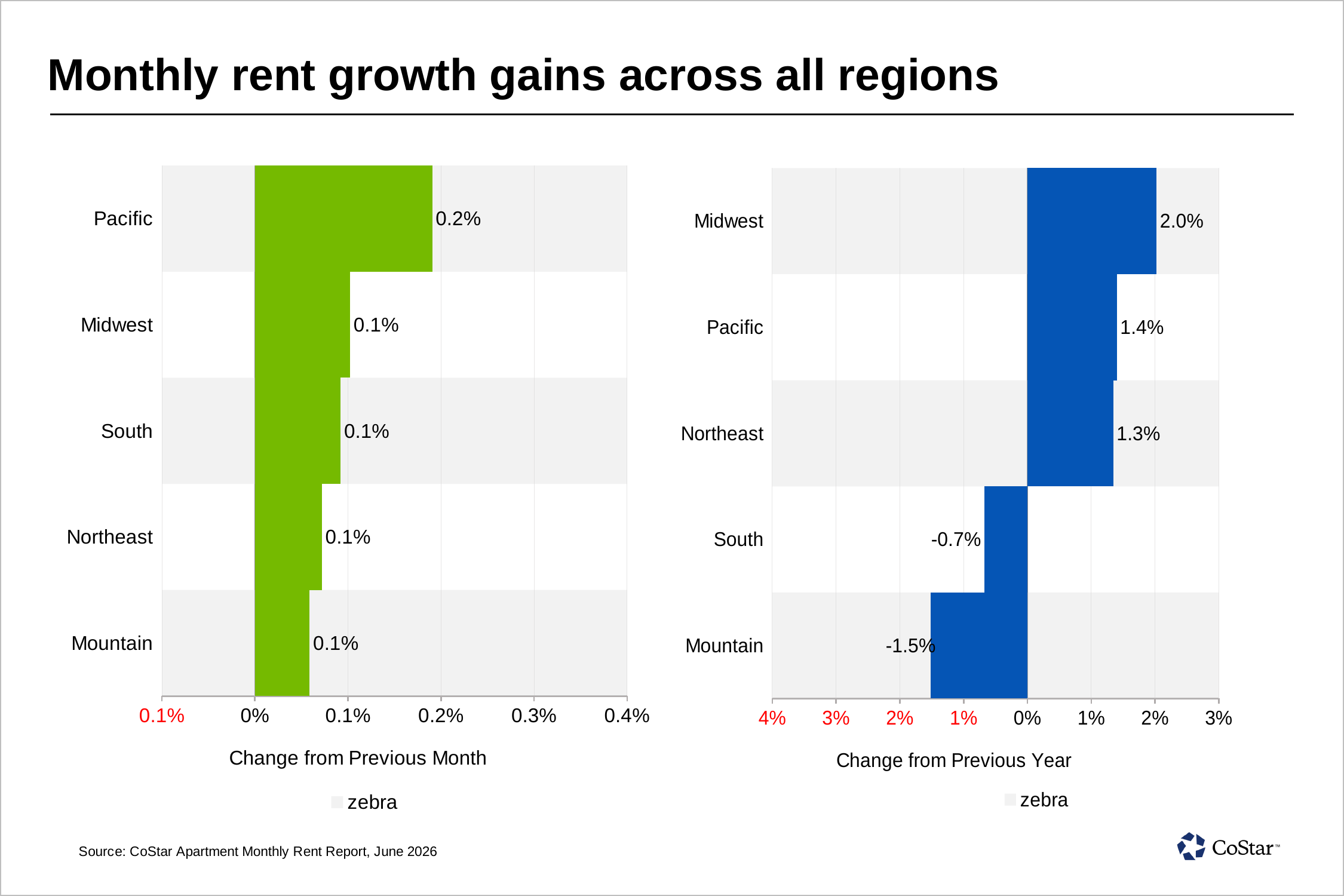
How many regions are shown in the 'Change from Previous Month' chart? 5 In the 'Change from Previous Year' chart, is the value for Midwest greater or less than 1%? greater In the 'Change from Previous Year' chart, what is the difference between the values for Midwest and Pacific? 0.6% In the 'Change from Previous Month' chart, which region has the highest value? Pacific What kind of chart is the 'Change from Previous Year' chart? bar chart In the 'Change from Previous Month' chart, what is the value for Pacific? 0.2% In the 'Change from Previous Year' chart, which region has the highest value? Midwest In the 'Change from Previous Year' chart, which region has the lowest value? Mountain In the 'Change from Previous Year' chart, which is larger, the value for Pacific or the value for Northeast? Pacific In the 'Change from Previous Year' chart, what is the value for South? -0.7% In the 'Change from Previous Year' chart, what is the value for Mountain? -1.5% What is the title of the slide? Monthly rent growth gains across all regions